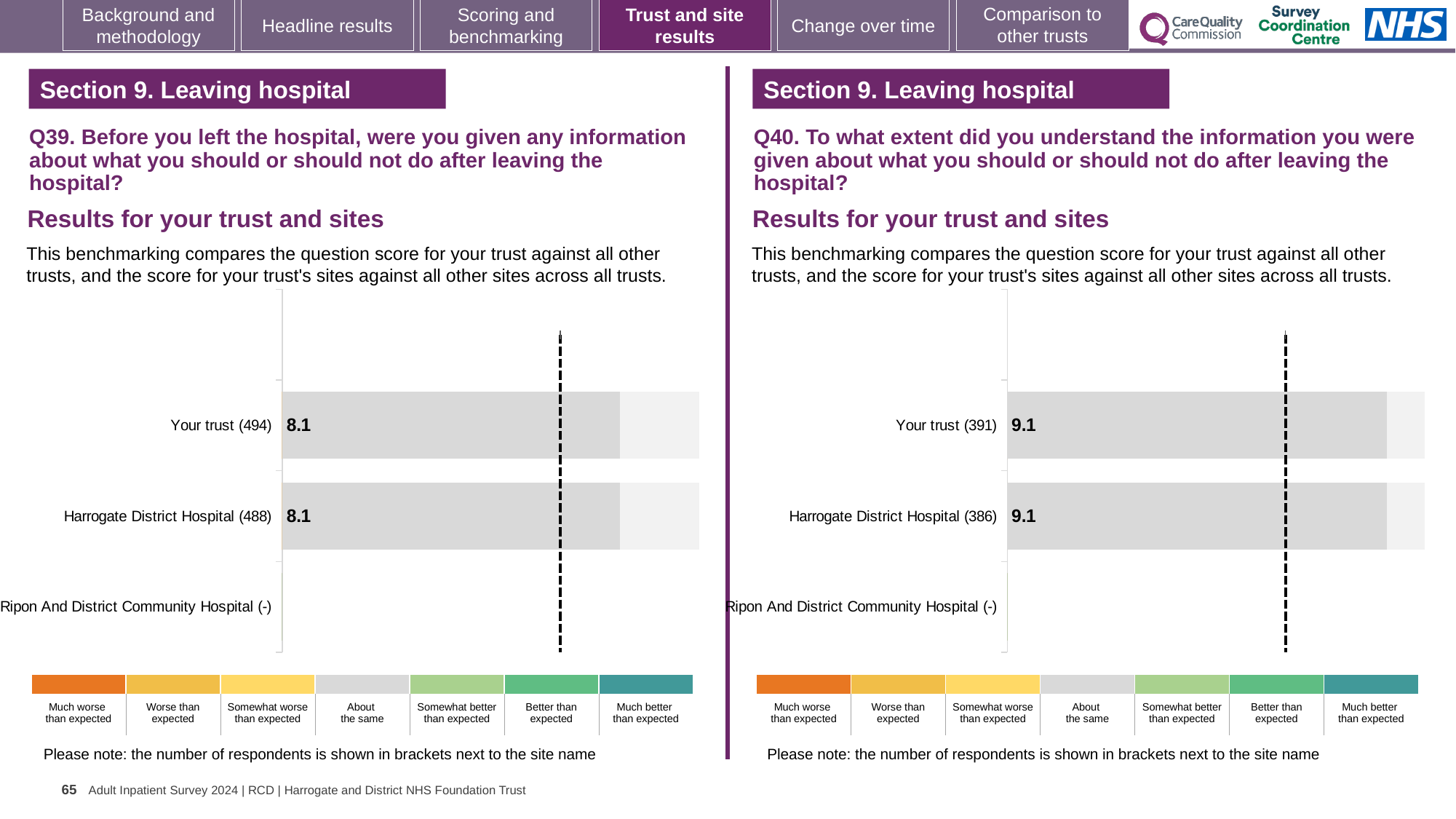
How many categories are listed on the y axis of the Q39 chart on the left? 3 How many categories are listed on the y axis of the Q40 chart on the right? 3 In the Q39 chart on the left, what is the score for Harrogate District Hospital? 8.1 In the Q39 chart on the left, what is the difference between the scores for Your trust and Harrogate District Hospital? 0 In the Q39 chart on the left, how many respondents are shown in brackets for Your trust? 494 In the Q39 chart on the left, what is the score for Your trust? 8.1 In the Q40 chart on the right, what is the difference between the scores for Your trust and Harrogate District Hospital? 0 In the Q40 chart on the right, what is the score for Harrogate District Hospital? 9.1 In the Q40 chart on the right, what is the score for Your trust? 9.1 Is the score for Your trust in the Q40 chart on the right larger than the score for Your trust in the Q39 chart on the left? Yes In the Q40 chart on the right, how many respondents are shown in brackets for Harrogate District Hospital? 386 What kind of chart is the Q39 chart on the left? Bar chart